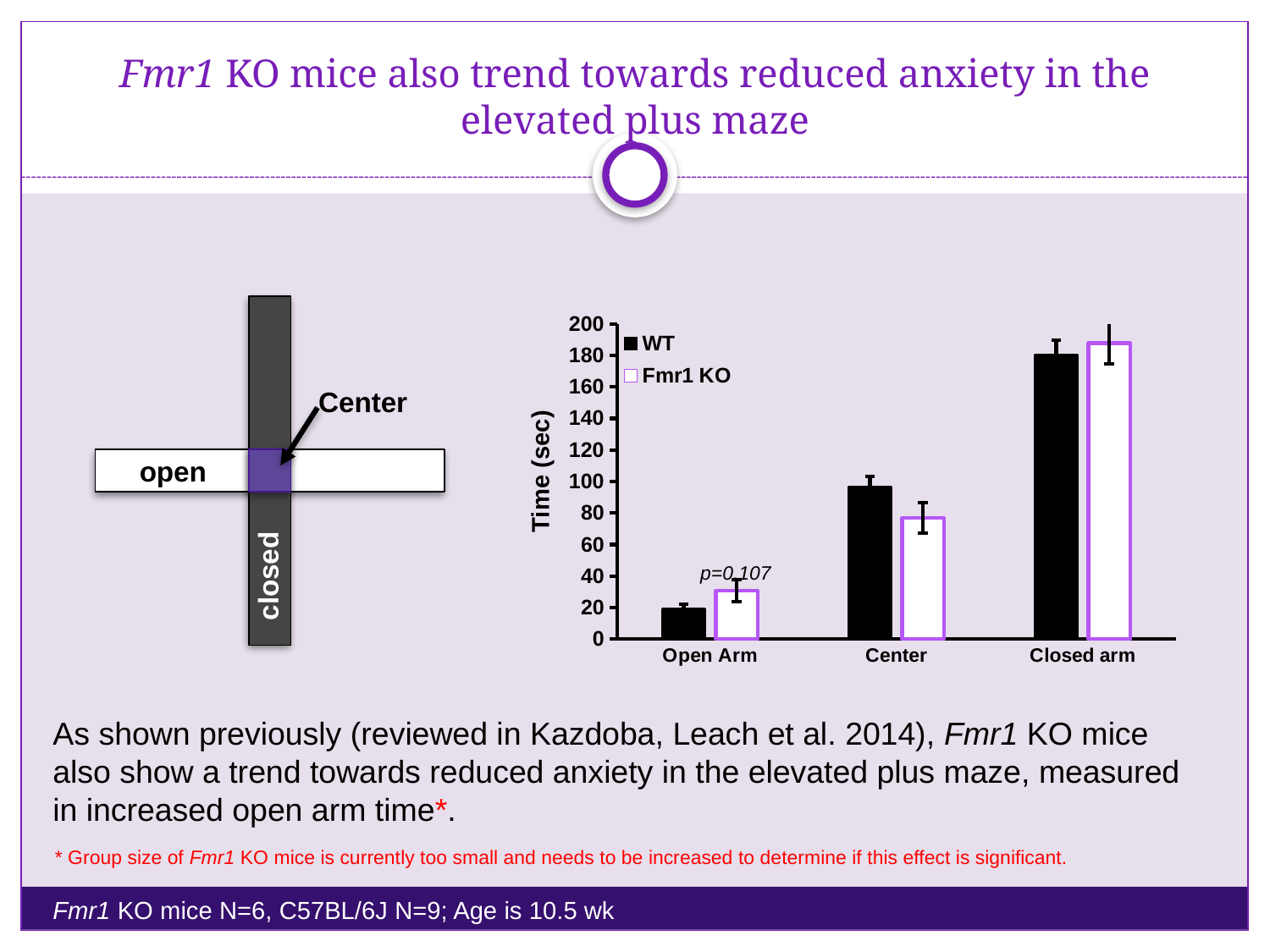
Which category has the highest WT value? Closed arm Is the Fmr1 KO value for Center greater or less than 100? less Which category has the lowest Fmr1 KO value? Open Arm In the Open Arm category, which series has the larger value, WT or Fmr1 KO? Fmr1 KO How many categories are shown on the x axis of the chart? 3 Is the WT value for Center greater or less than 80? greater What kind of chart is shown on the slide? bar chart What p-value is annotated above the Open Arm bars? p=0.107 Is the WT value for Closed arm greater or less than 160? greater How many series does the chart legend list? 2 What is the label of the y axis of the chart? Time (sec) In the Center category, which series has the larger value, WT or Fmr1 KO? WT